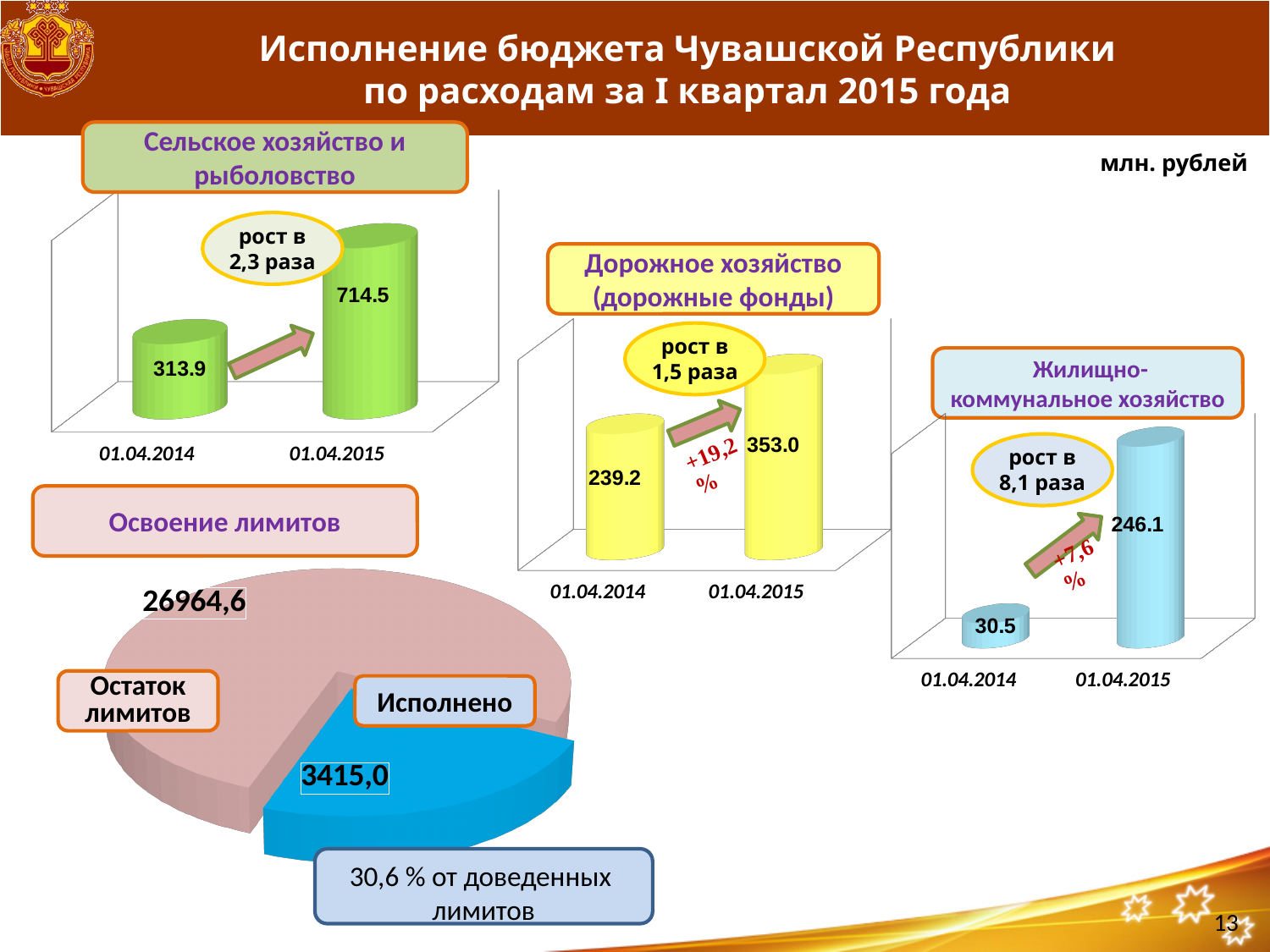
In the 'Дорожное хозяйство (дорожные фонды)' chart, what is the value for 01.04.2014? 239.2 In the 'Освоение лимитов' chart, what is the value for 'Остаток лимитов'? 26964,6 In the 'Жилищно-коммунальное хозяйство' chart, which date has the lowest value? 01.04.2014 In the 'Дорожное хозяйство (дорожные фонды)' chart, what is the difference between the 01.04.2015 and 01.04.2014 values? 113.8 In the 'Сельское хозяйство и рыболовство' chart, what is the value for 01.04.2014? 313.9 In the 'Жилищно-коммунальное хозяйство' chart, what is the difference between the 01.04.2015 and 01.04.2014 values? 215.6 How many bar charts are on the slide? 3 In the 'Сельское хозяйство и рыболовство' chart, do the values rise or fall from 01.04.2014 to 01.04.2015? rise In the 'Сельское хозяйство и рыболовство' chart, what is the value for 01.04.2015? 714.5 In the 'Жилищно-коммунальное хозяйство' chart, what is the value for 01.04.2015? 246.1 In the 'Освоение лимитов' chart, what is the value for 'Исполнено'? 3415,0 What kind of chart is the 'Освоение лимитов' chart? pie chart